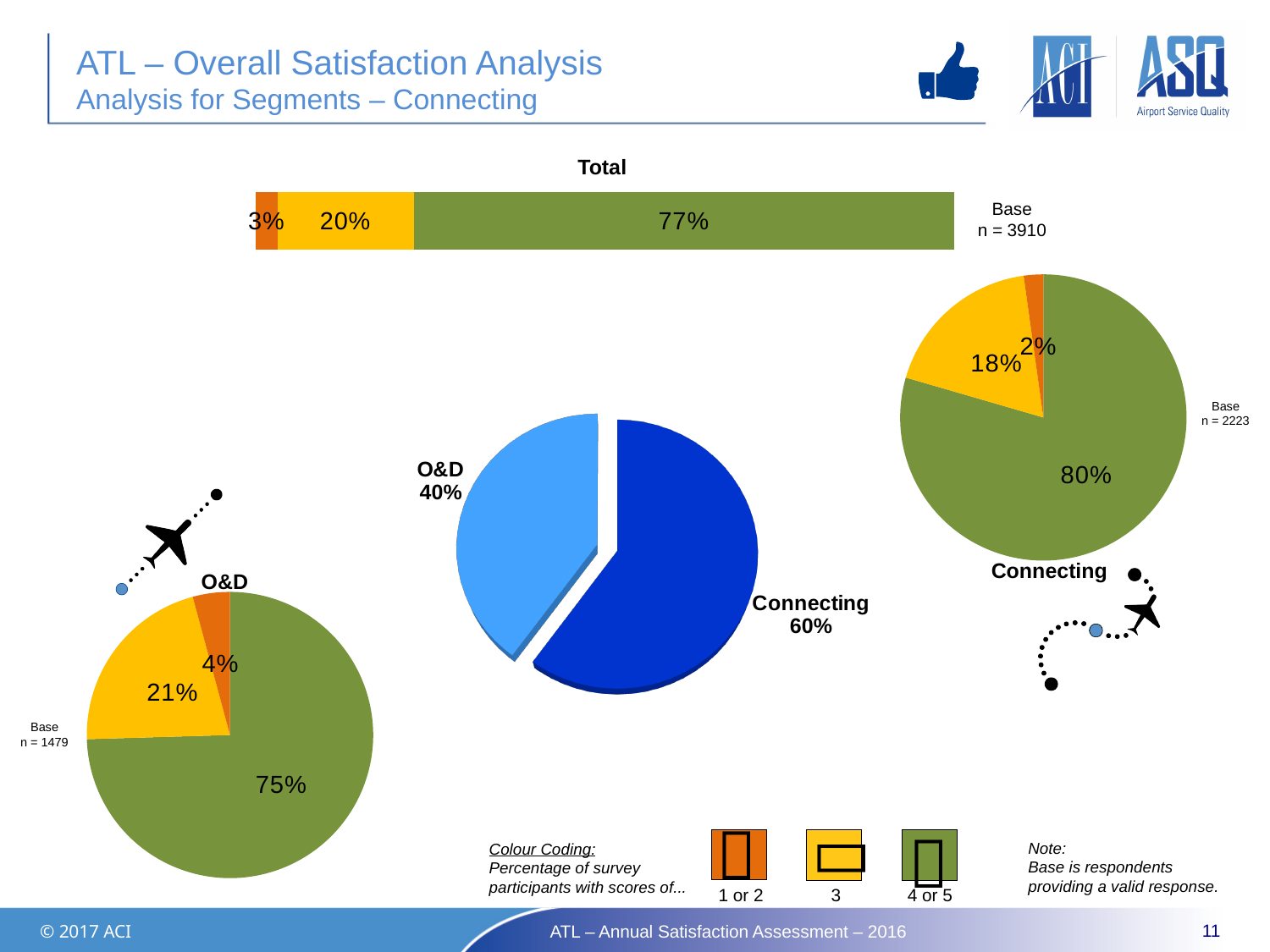
In the "Connecting" pie chart, which score group has the smallest share? 1 or 2 Comparing the "O&D" and "Connecting" pie charts, which segment has the higher share of scores of 4 or 5? Connecting In the "O&D" pie chart, what percentage of participants gave scores of 1 or 2? 4% What kind of chart is the "Total" chart at the top of the slide? Stacked bar chart In the "Total" stacked bar chart, what percentage of participants gave a score of 3? 20% In the "O&D" pie chart, what percentage of participants gave scores of 4 or 5? 75% In the centre pie chart splitting segments, which segment has the larger share, O&D or Connecting? Connecting In the centre pie chart splitting segments, what share is Connecting? 60% In the "Total" stacked bar chart, what percentage of participants gave scores of 4 or 5? 77% In the centre pie chart splitting segments, how many slices are there? 2 In the "Connecting" pie chart, what percentage of participants gave scores of 4 or 5? 80% In the "Total" stacked bar chart, what is the difference between the share with scores of 4 or 5 and the share with a score of 3? 57 percentage points